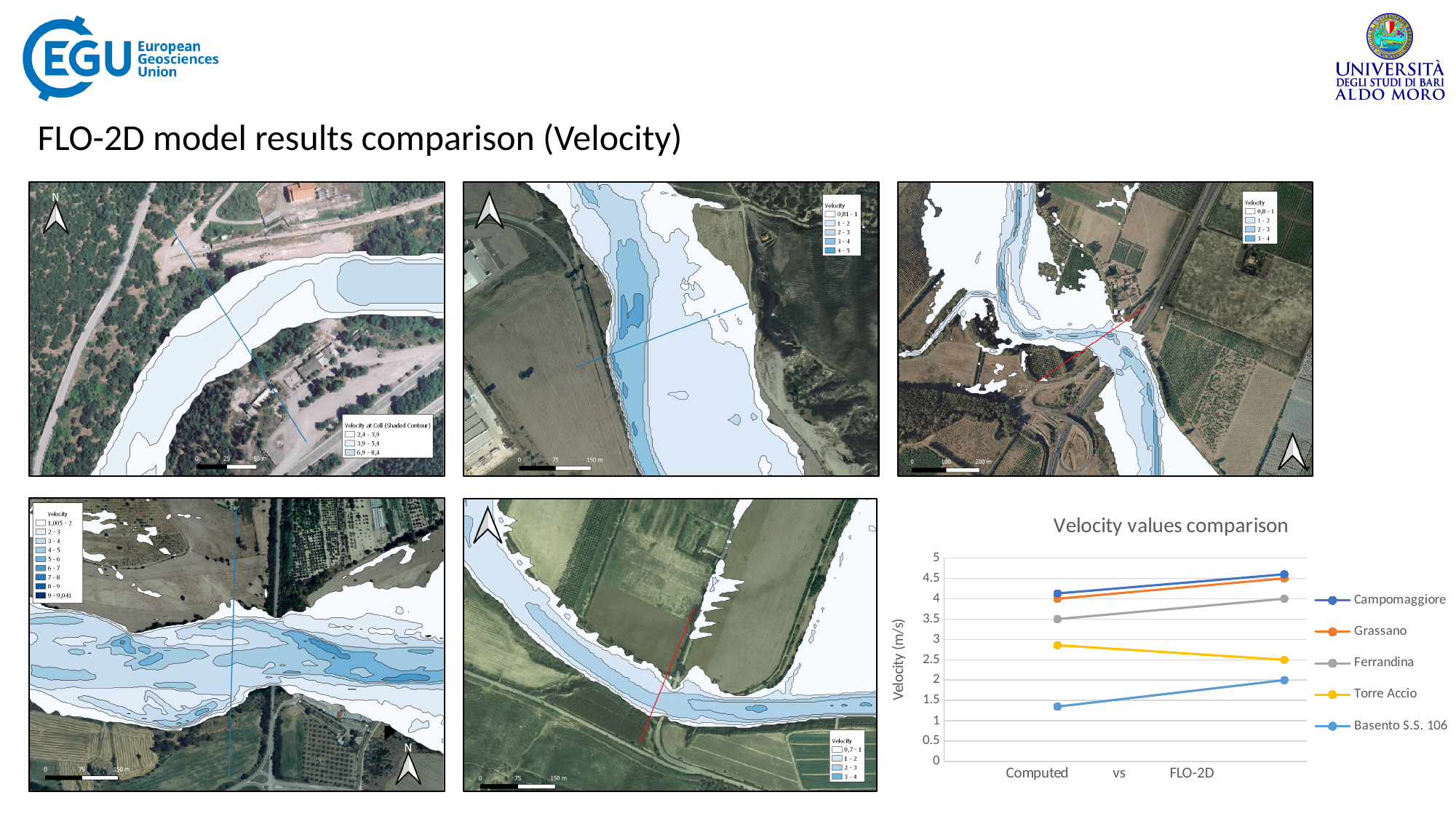
In the 'Velocity values comparison' chart, is the Computed value for Torre Accio greater or less than 2.5? greater In the 'Velocity values comparison' chart, is the FLO-2D value for Ferrandina greater or less than 3.5? greater In the 'Velocity values comparison' chart, does the Torre Accio line rise or fall from Computed to FLO-2D? fall In the 'Velocity values comparison' chart, which series has the lowest Computed value? Basento S.S. 106 How many categories are shown on the x axis of the 'Velocity values comparison' chart? 2 What is the title of the line chart on the slide? Velocity values comparison What kind of chart is the 'Velocity values comparison' chart? line chart How many series does the legend of the 'Velocity values comparison' chart list? 5 In the 'Velocity values comparison' chart, does the Basento S.S. 106 line rise or fall from Computed to FLO-2D? rise What is the y-axis title of the 'Velocity values comparison' chart? Velocity (m/s) In the 'Velocity values comparison' chart, is the Computed value for Basento S.S. 106 greater or less than 1.5? less In the 'Velocity values comparison' chart, which is larger at FLO-2D: Ferrandina or Torre Accio? Ferrandina